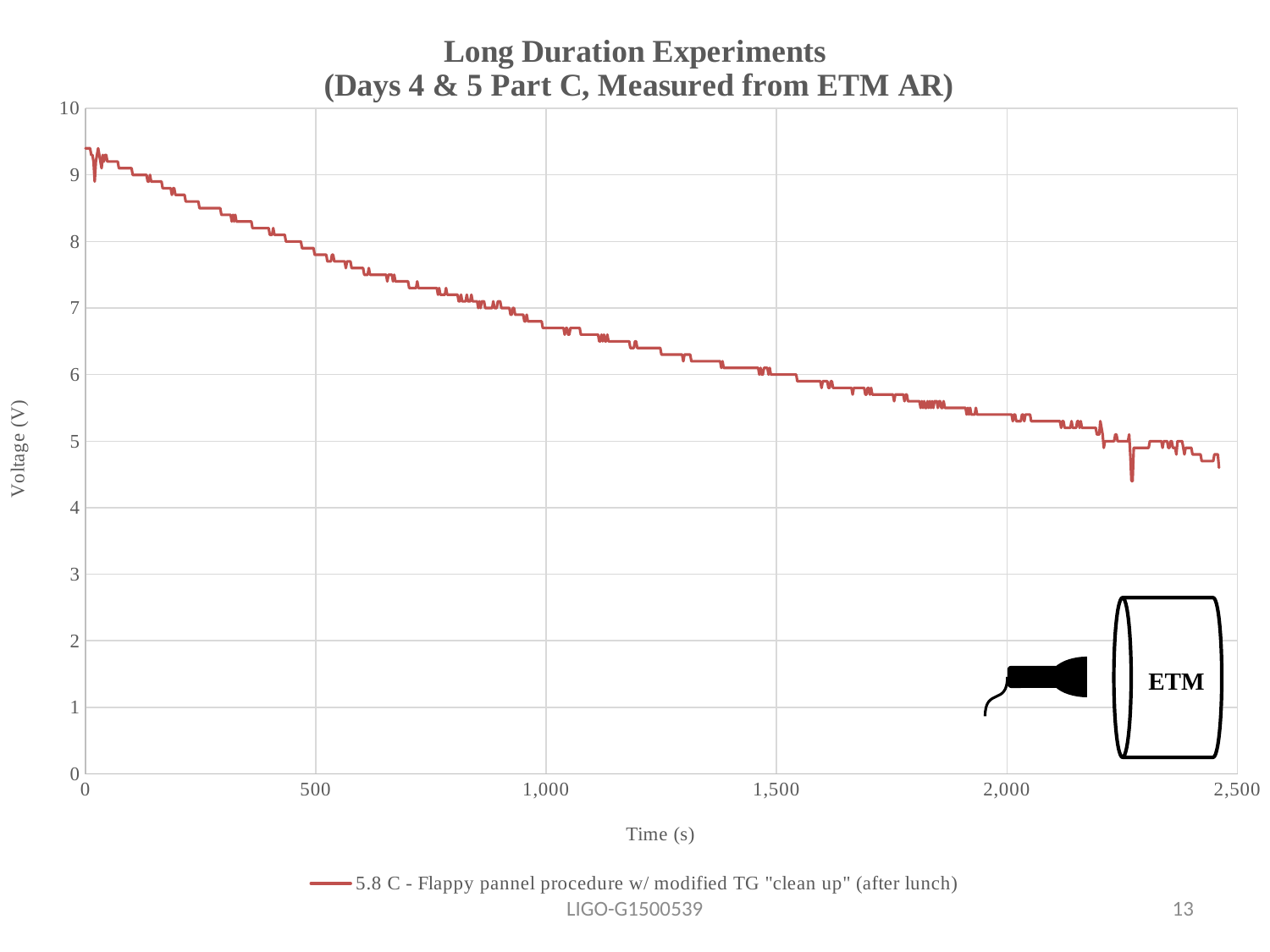
Is the voltage at 500 s greater or less than 8? less Is the voltage at time 0 s greater or less than 9? greater How many series does the legend list? 1 Is the voltage at 1,500 s greater or less than 7? less What is the title of the chart? Long Duration Experiments (Days 4 & 5 Part C, Measured from ETM AR) Does the voltage rise or fall as time increases along the x axis? fall What is the label of the y axis? Voltage (V) What kind of chart is shown on the slide? line chart